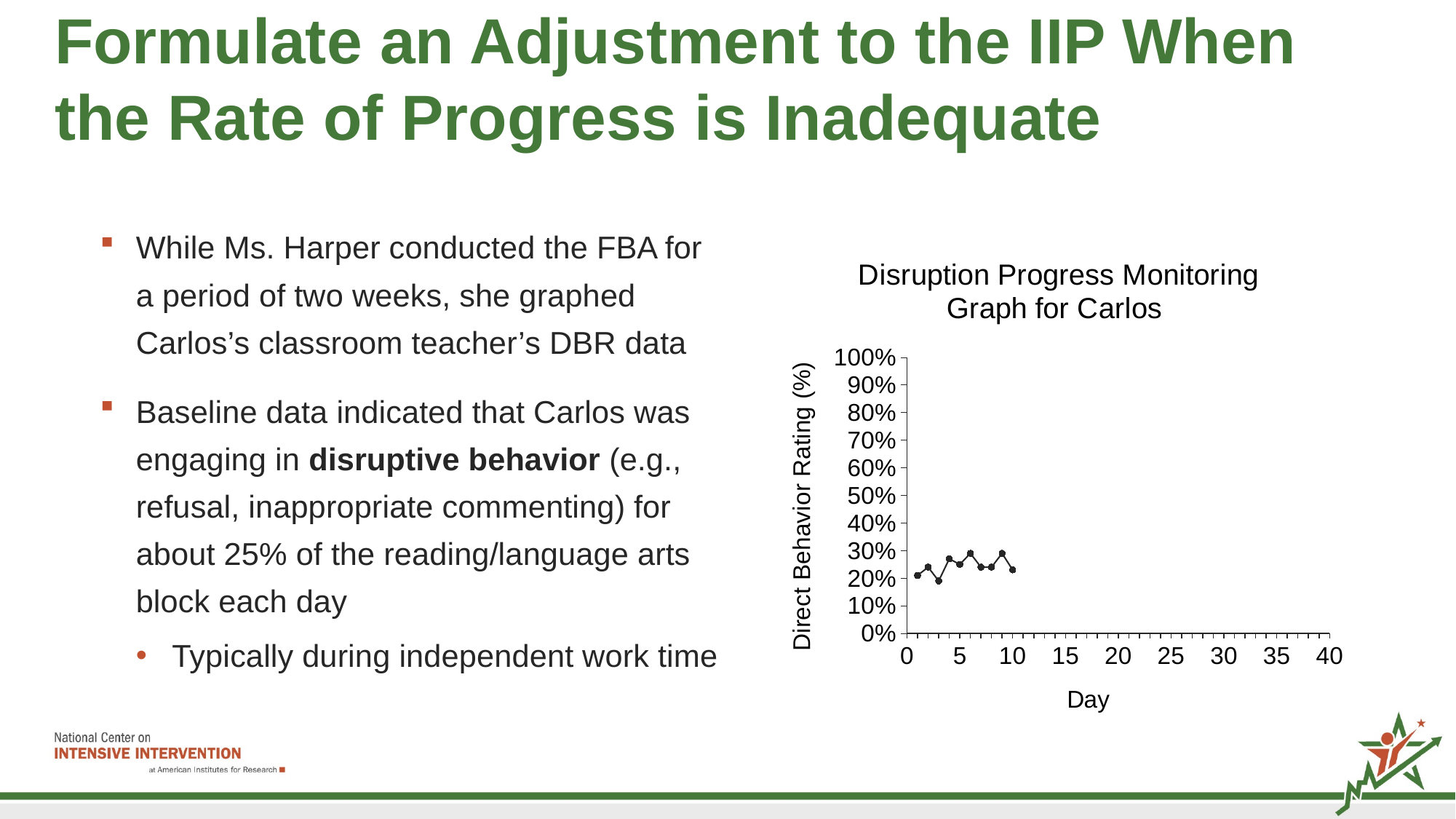
Which is larger, the value for day 4 or the value for day 1? day 4 Is the value for day 6 greater or less than 20%? greater What is the label of the y axis of the chart? Direct Behavior Rating (%) Is the value for day 1 greater or less than 10%? greater On which day is the lowest Direct Behavior Rating plotted? 3 Is the value for day 9 greater or less than 40%? less Which is larger, the value for day 3 or the value for day 6? day 6 What type of chart is shown on the slide? line chart How many data points are plotted on the chart? 10 What is the title of the chart? Disruption Progress Monitoring Graph for Carlos